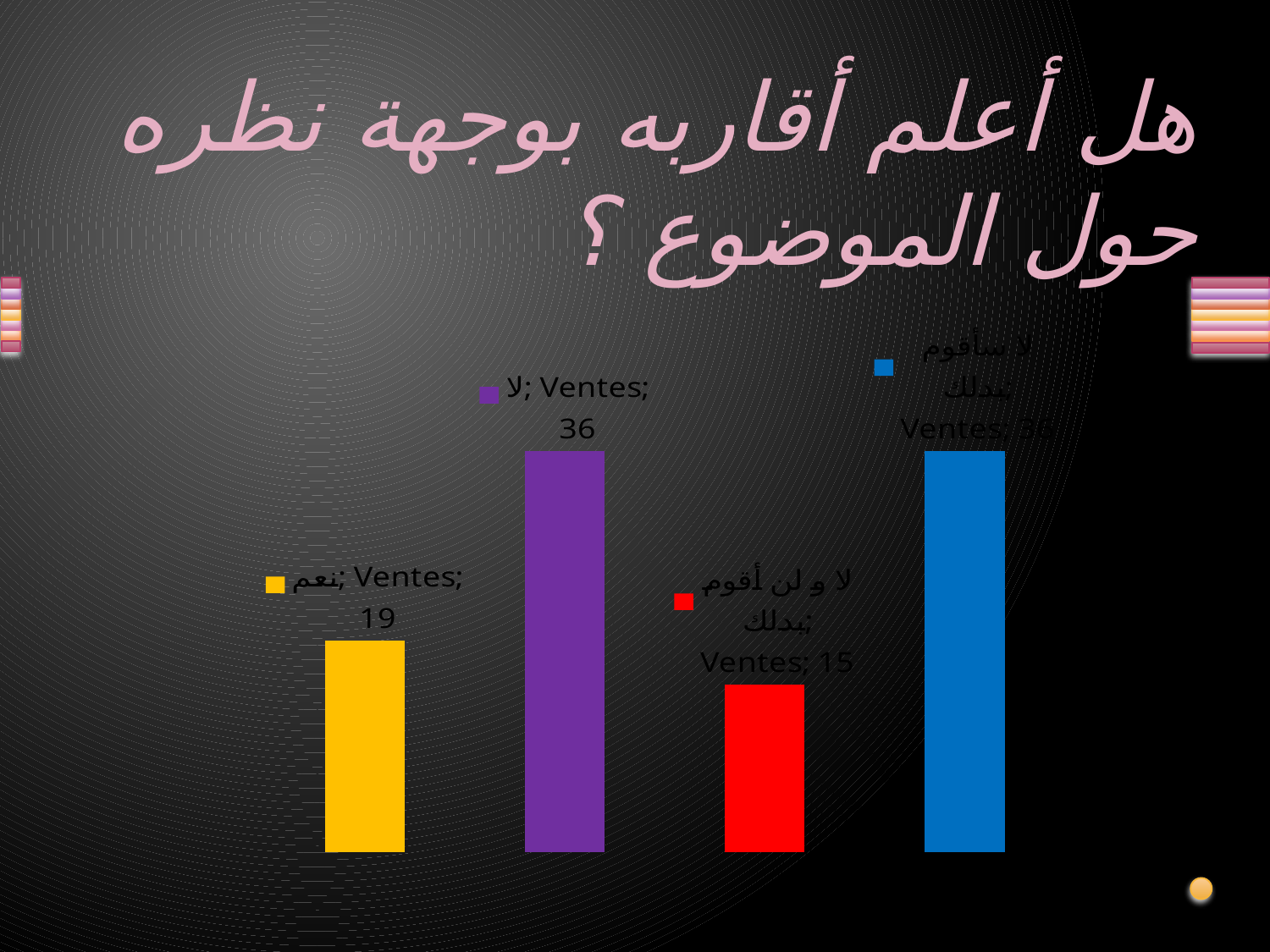
Which is larger, the value for "لا" or the value for "نعم"? لا What is the difference between the values for "لا" and "نعم"? 17 Which is larger, the value for "نعم" or the value for "لا و لن أقوم بذلك"? نعم What is the value for the category "لا" in the chart? 36 Which category has the lowest value in the chart? لا و لن أقوم بدلك How many bars are shown in the chart? 4 What is the name of the data series shown in the chart's data labels? Ventes What is the value for the category "نعم" in the chart? 19 What colour is the bar for the category "نعم"? yellow What kind of chart is shown on the slide? bar chart What is the difference between the values for "نعم" and "لا و لن أقوم بذلك"? 4 What is the value for the category "لا و لن أقوم بذلك" in the chart? 15